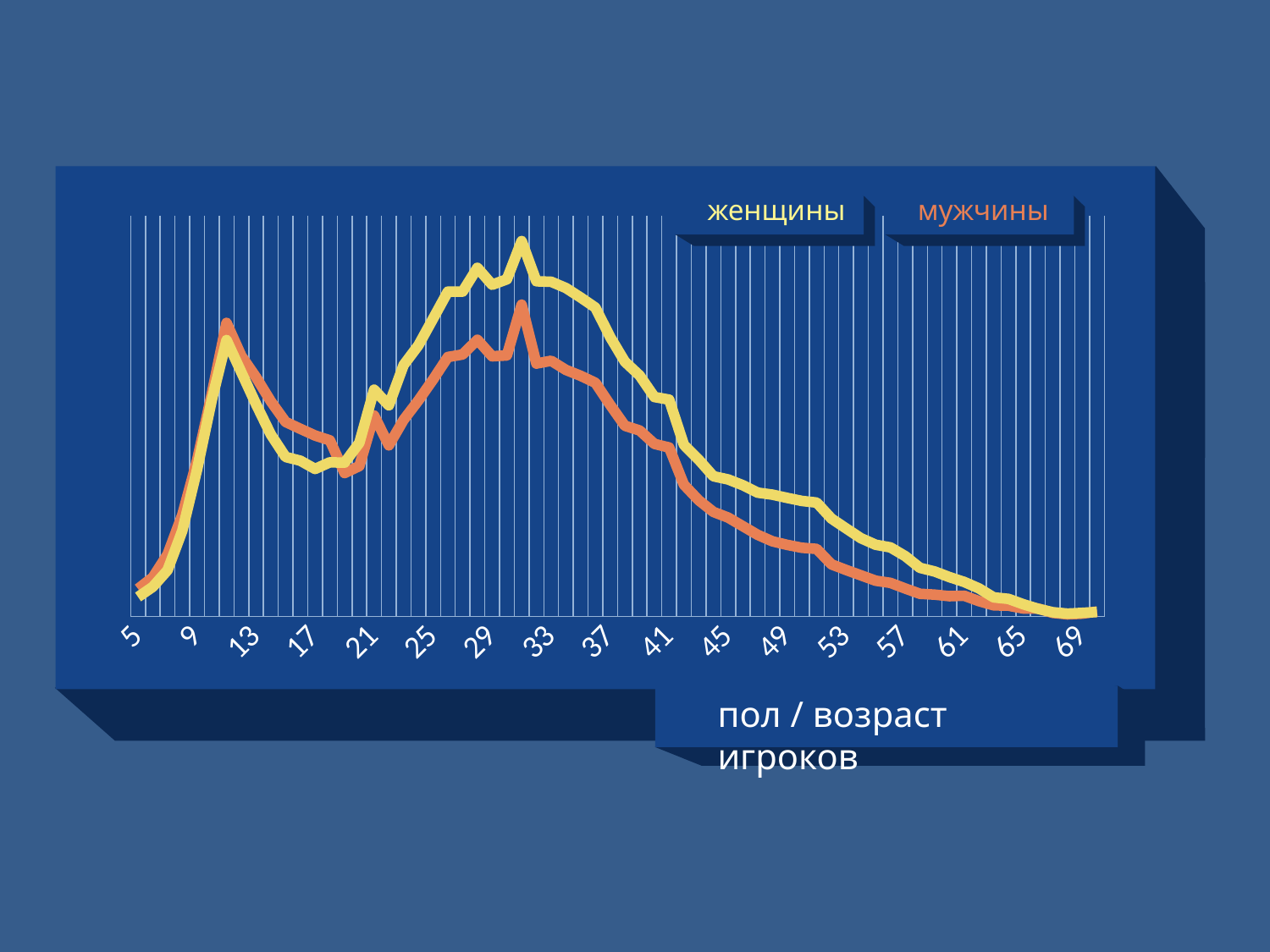
What are the two series named in the legend? женщины, мужчины What is the title of the chart? пол / возраст игроков Which series reaches the higher overall peak? женщины At age 29, which series has the higher value, женщины or мужчины? женщины Which series is drawn in yellow? женщины At age 17, which series has the higher value, женщины or мужчины? мужчины How many series does the legend list? 2 Do the values for мужчины rise or fall between age 5 and age 12? rise How many age labels are shown on the x axis? 17 At age 45, which series has the higher value, женщины or мужчины? женщины What kind of chart is shown on the slide? line chart Do the values for женщины rise or fall between age 33 and age 69? fall